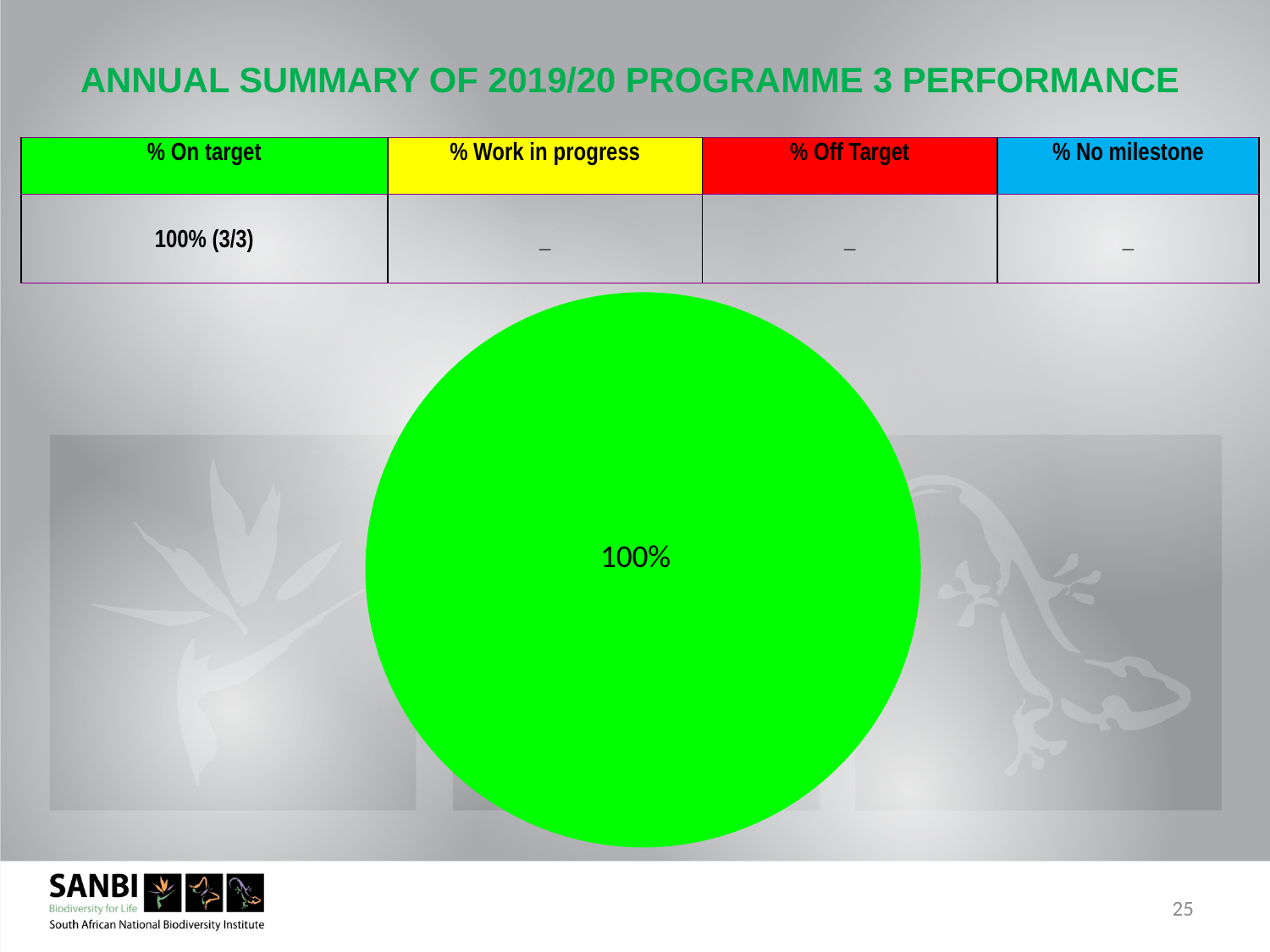
Is the value shown on the pie chart greater or less than 50%? greater How many slices does the pie chart have? 1 What share of the pie does the single slice take up? 100% What kind of chart is shown on the slide? pie chart What colour is the slice of the pie chart? green What percentage is printed on the pie chart's slice? 100% Which performance category from the table does the green pie slice correspond to? % On target